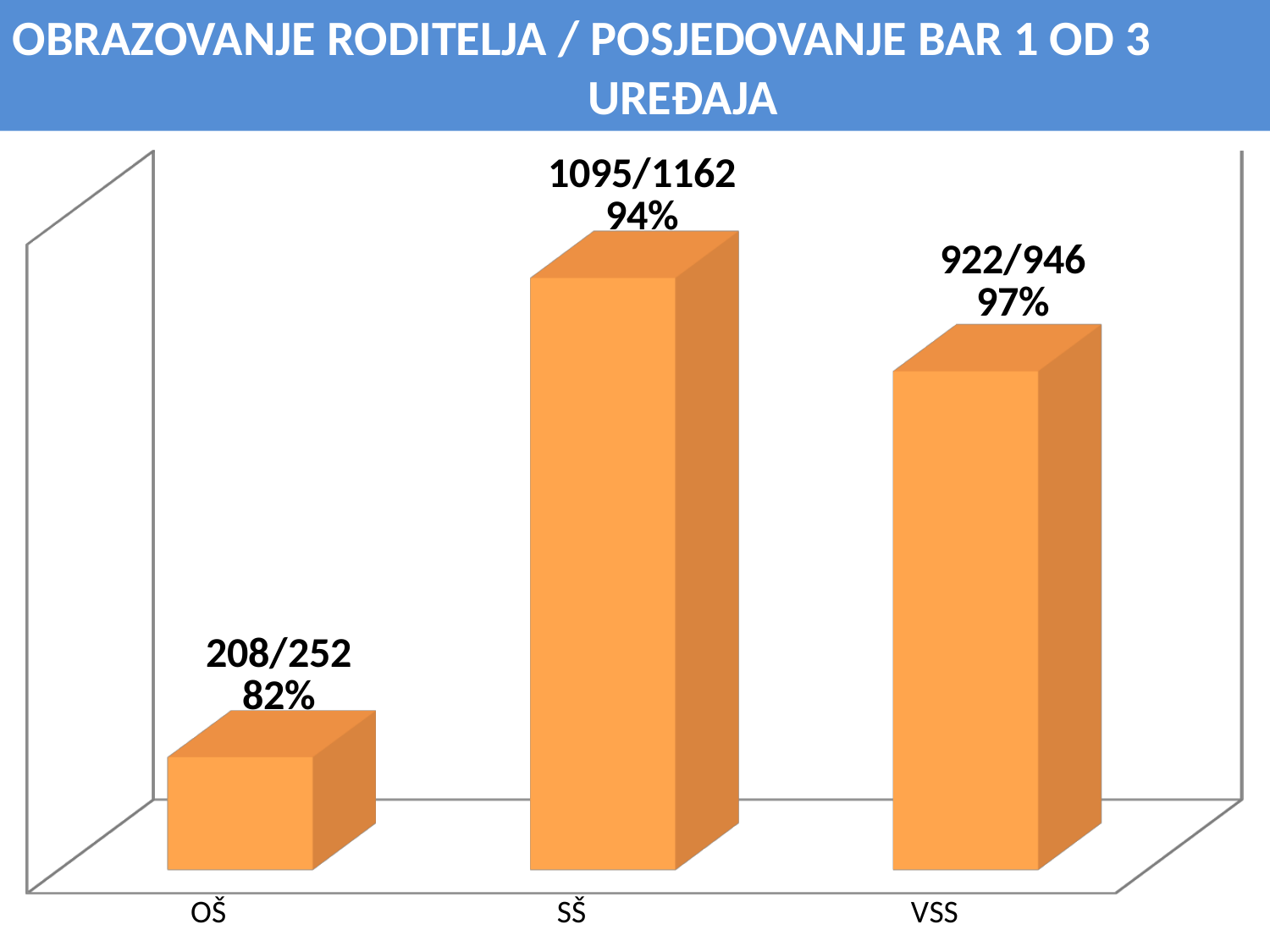
How many categories are shown on the x axis? 3 Which category has the tallest bar? SŠ Which bar is taller, the one for SŠ or the one for VSS? SŠ What fraction is shown above the bar for VSS? 922/946 Which category has the shortest bar? OŠ What kind of chart is shown on the slide? Bar chart Which category shows the highest percentage? VSS What percentage is shown for VSS? 97% What percentage is shown for SŠ? 94% What is the difference between the percentages shown for VSS and OŠ? 15 percentage points What is the title of the chart? OBRAZOVANJE RODITELJA / POSJEDOVANJE BAR 1 OD 3 UREĐAJA What data label is shown above the bar for OŠ? 208/252 82%